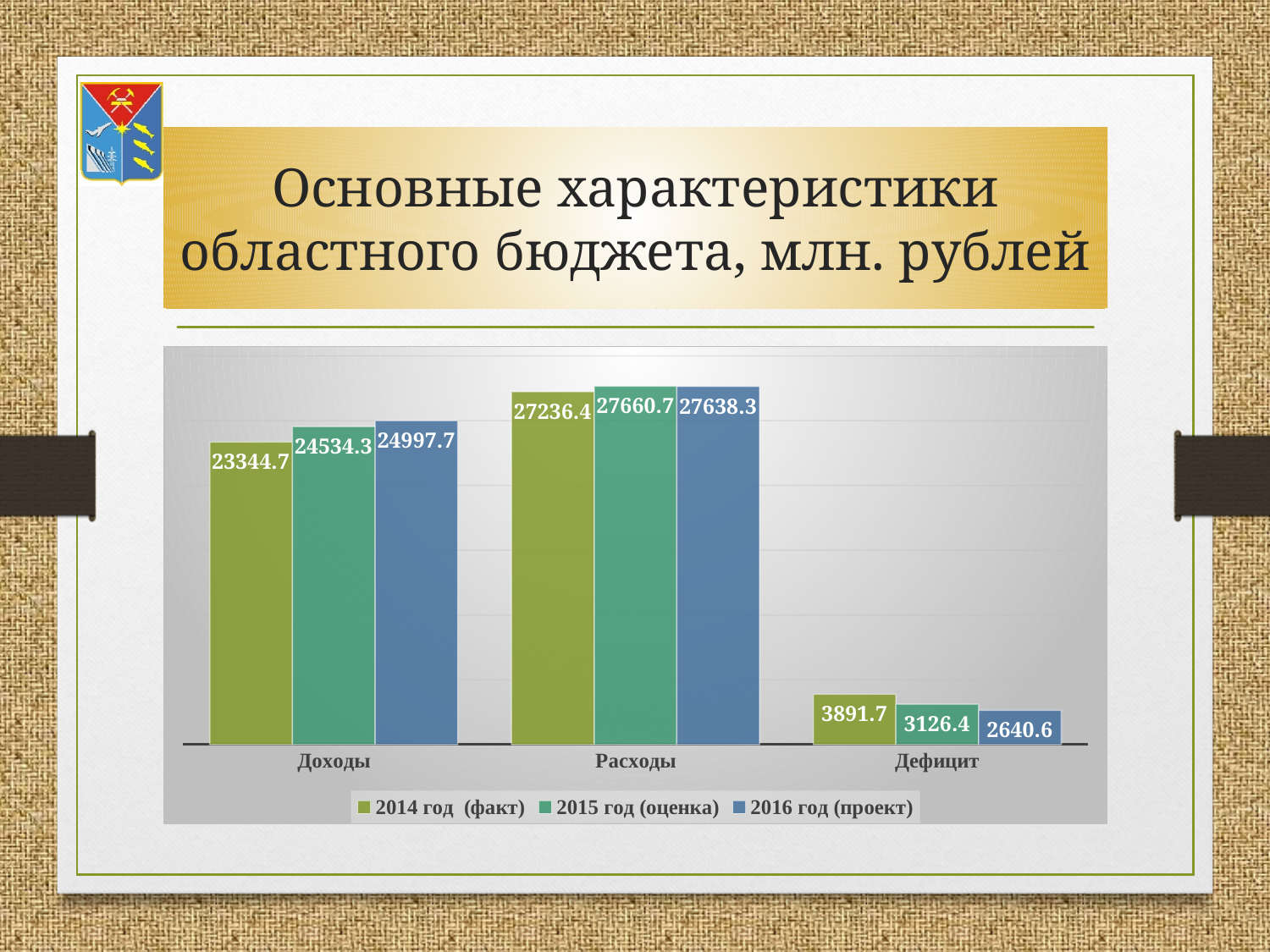
What is the value for Дефицит in the 2015 год (оценка) series? 3126.4 What is the difference between the 2014 год (факт) and 2016 год (проект) values for Дефицит? 1251.1 Which category has the lowest value in the 2016 год (проект) series? Дефицит What kind of chart is shown on the slide? Bar chart What is the value for Доходы in the 2014 год (факт) series? 23344.7 Which is larger: the 2014 год (факт) value for Дефицит or the 2016 год (проект) value for Дефицит? 2014 год (факт) Do the values for Дефицит rise or fall from 2014 год (факт) to 2016 год (проект)? Fall How many series does the legend list? 3 Which category has the highest value in the 2015 год (оценка) series? Расходы What is the difference between the 2016 год (проект) and 2014 год (факт) values for Доходы? 1653.0 How many categories are shown on the x axis? 3 What is the value for Расходы in the 2016 год (проект) series? 27638.3